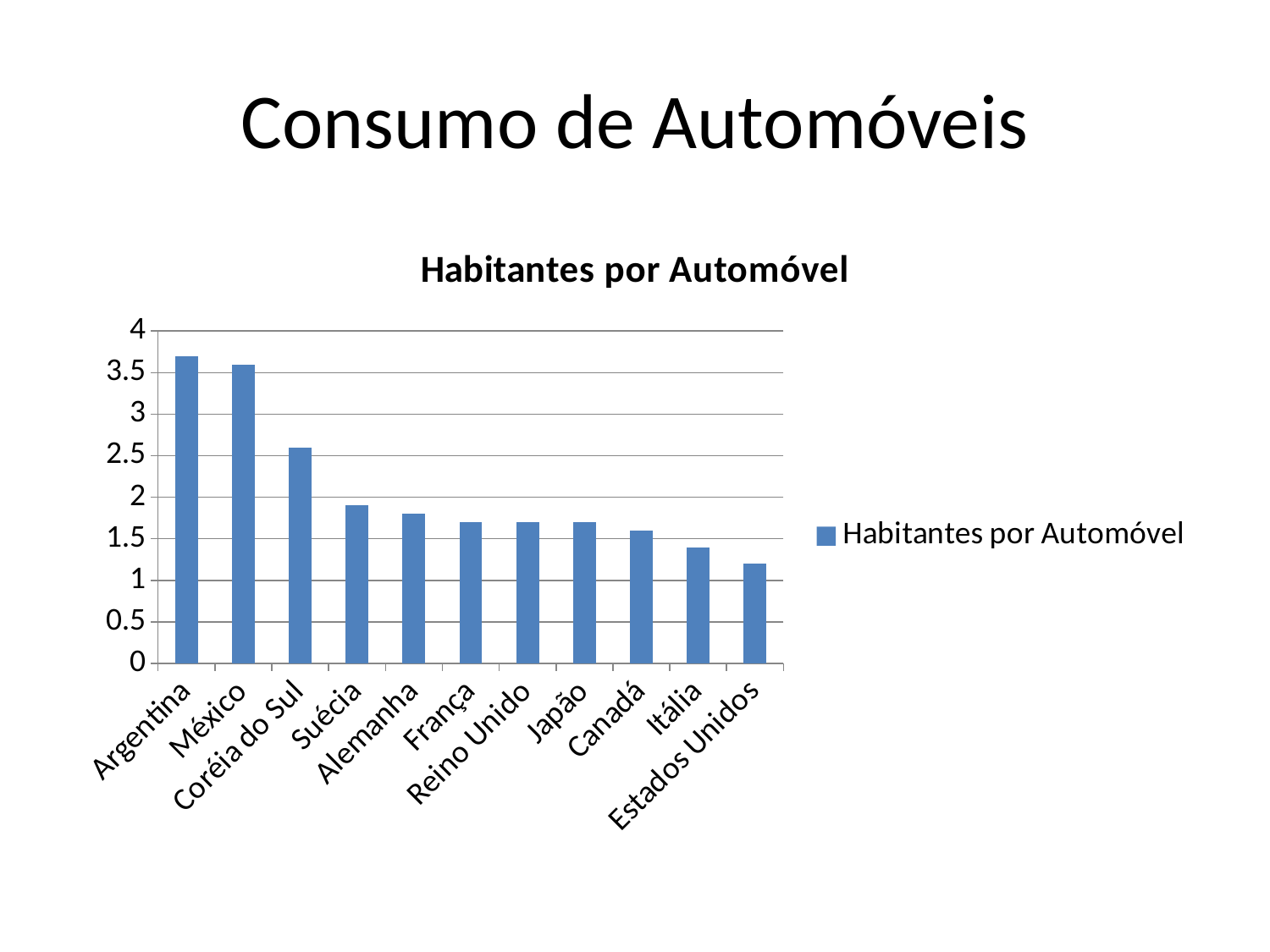
Which country has the lowest value for Habitantes por Automóvel? Estados Unidos Do the values generally rise or fall from left to right along the x axis? fall What is the title of the chart? Habitantes por Automóvel Which country has the highest value for Habitantes por Automóvel? Argentina Is the value for Coréia do Sul greater or less than 2? greater How many series does the legend list? 1 Which has a larger value, Coréia do Sul or Suécia? Coréia do Sul Is the value for Suécia greater or less than 2? less Is the value for Argentina greater or less than 3.5? greater What kind of chart is shown on the slide? bar chart How many countries are shown on the x axis of the chart? 11